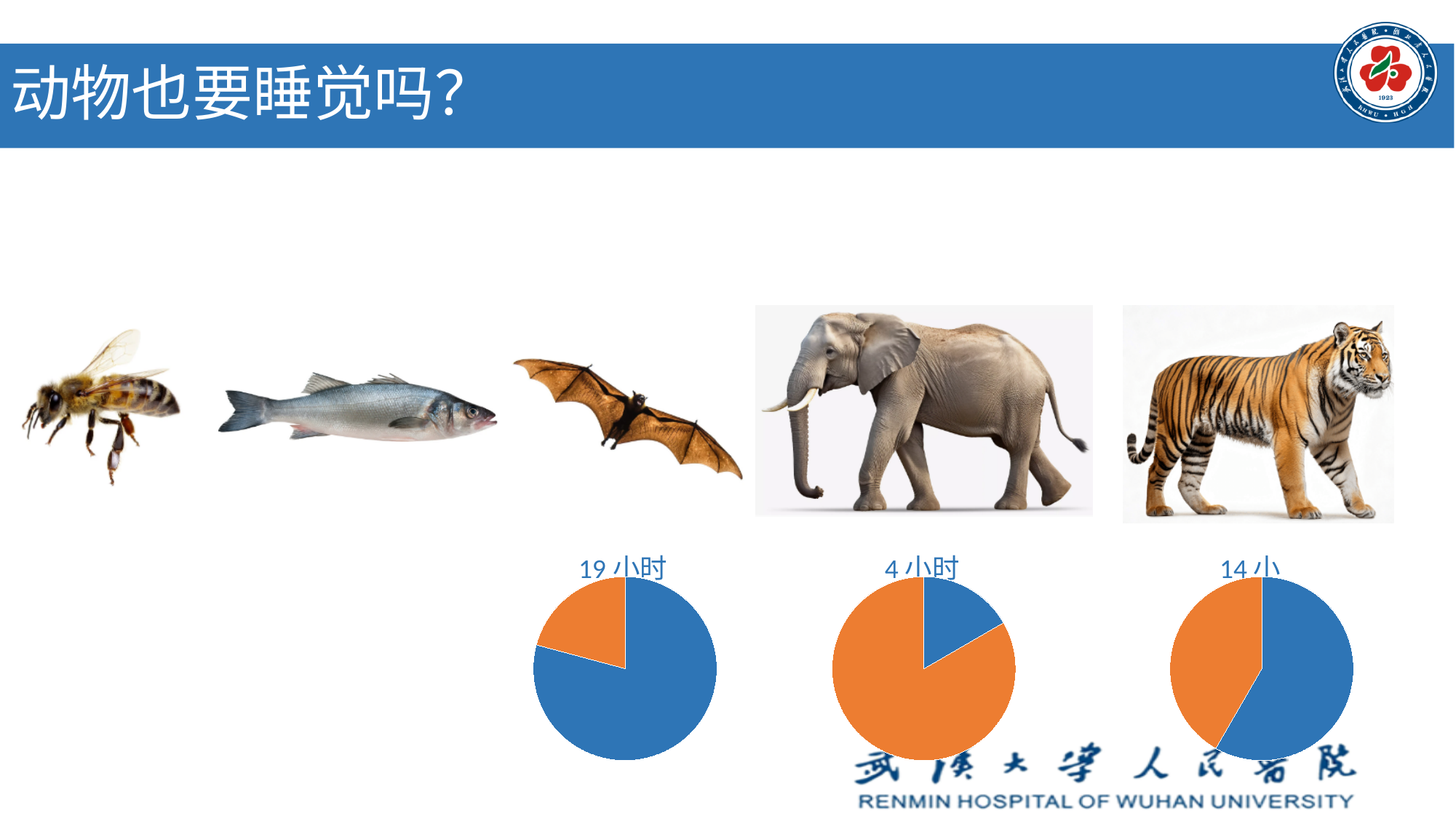
Which of the three pie charts has the smallest blue slice? the one under the elephant (4 小时) In the pie chart under the tiger, which slice is larger, the blue one or the orange one? blue What is the label printed above the pie chart under the bat? 19 小时 How many slices does the pie chart under the elephant have? 2 Is the blue slice in the pie chart under the elephant more or less than half of the pie? less What is the label printed above the pie chart under the elephant? 4 小时 How many pie charts are on the slide? 3 In the pie chart under the elephant, which slice is larger, the blue one or the orange one? orange Which two colours are used for the slices in the pie charts? blue and orange Which of the three pie charts has the largest blue slice? the one under the bat (19 小时) In the pie chart under the bat, which slice is larger, the blue one or the orange one? blue What kind of chart is shown under the bat? pie chart